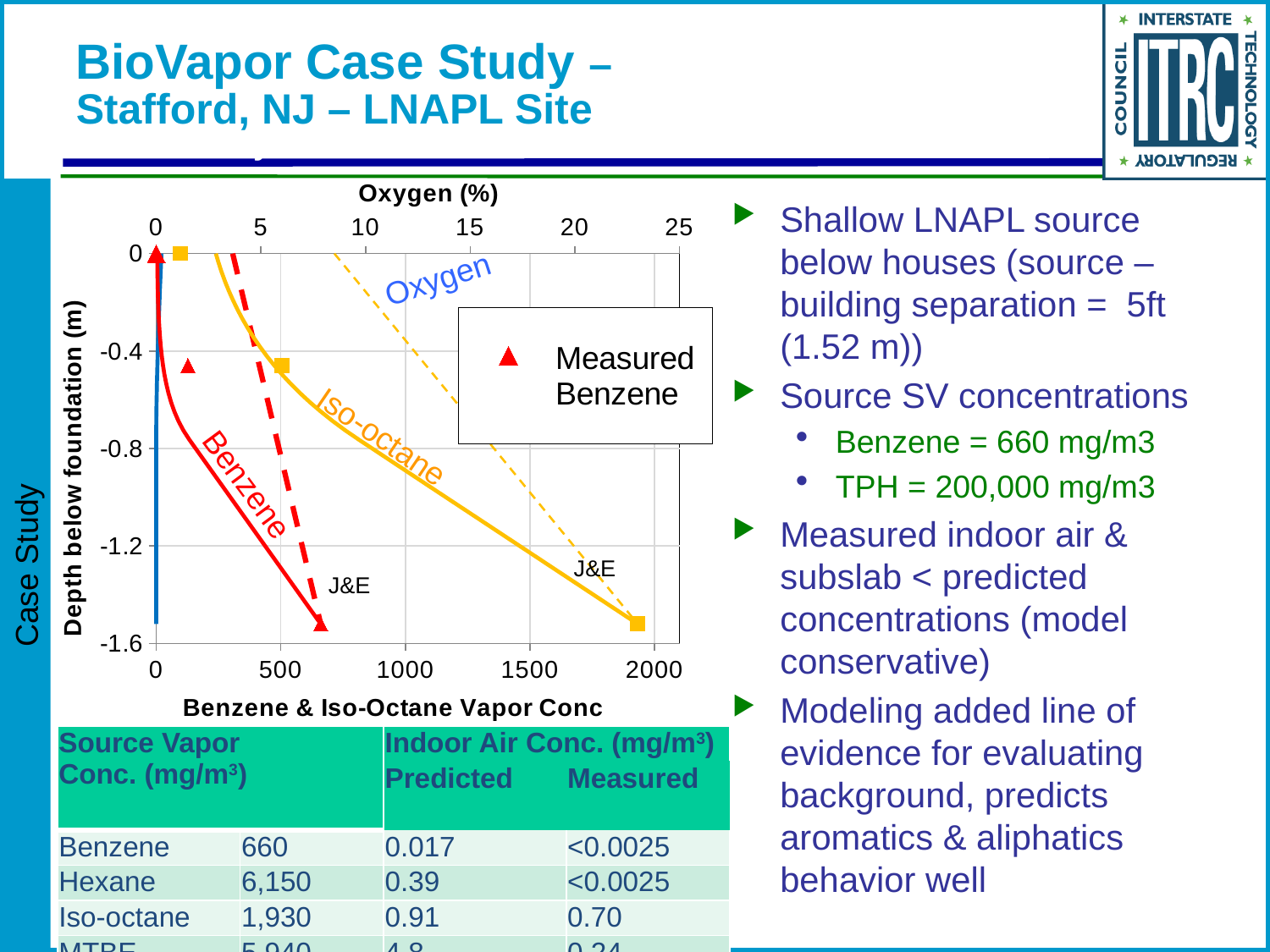
Does the Benzene vapor concentration line increase or decrease as depth below the foundation increases (moving down the chart)? increase How many Measured Benzene triangle points are plotted on the chart? 3 At the deepest measured points, which is larger: the measured iso-octane concentration or the measured benzene concentration? measured iso-octane What is the title of the bottom horizontal axis of the chart? Benzene & Iso-Octane Vapor Conc Is the deepest Measured Benzene point (red triangle near the bottom of the chart) greater or less than 500 on the vapor concentration axis? greater What series does the chart legend list? Measured Benzene What is the label on the vertical axis of the chart? Depth below foundation (m) Is the deepest measured iso-octane point (yellow square near the bottom of the chart) greater or less than 1500 on the vapor concentration axis? greater What is the title of the top horizontal axis of the chart? Oxygen (%) Is the Measured Benzene point at about -0.4 m depth greater or less than 500 on the vapor concentration axis? less What kind of chart is shown on the slide? line chart